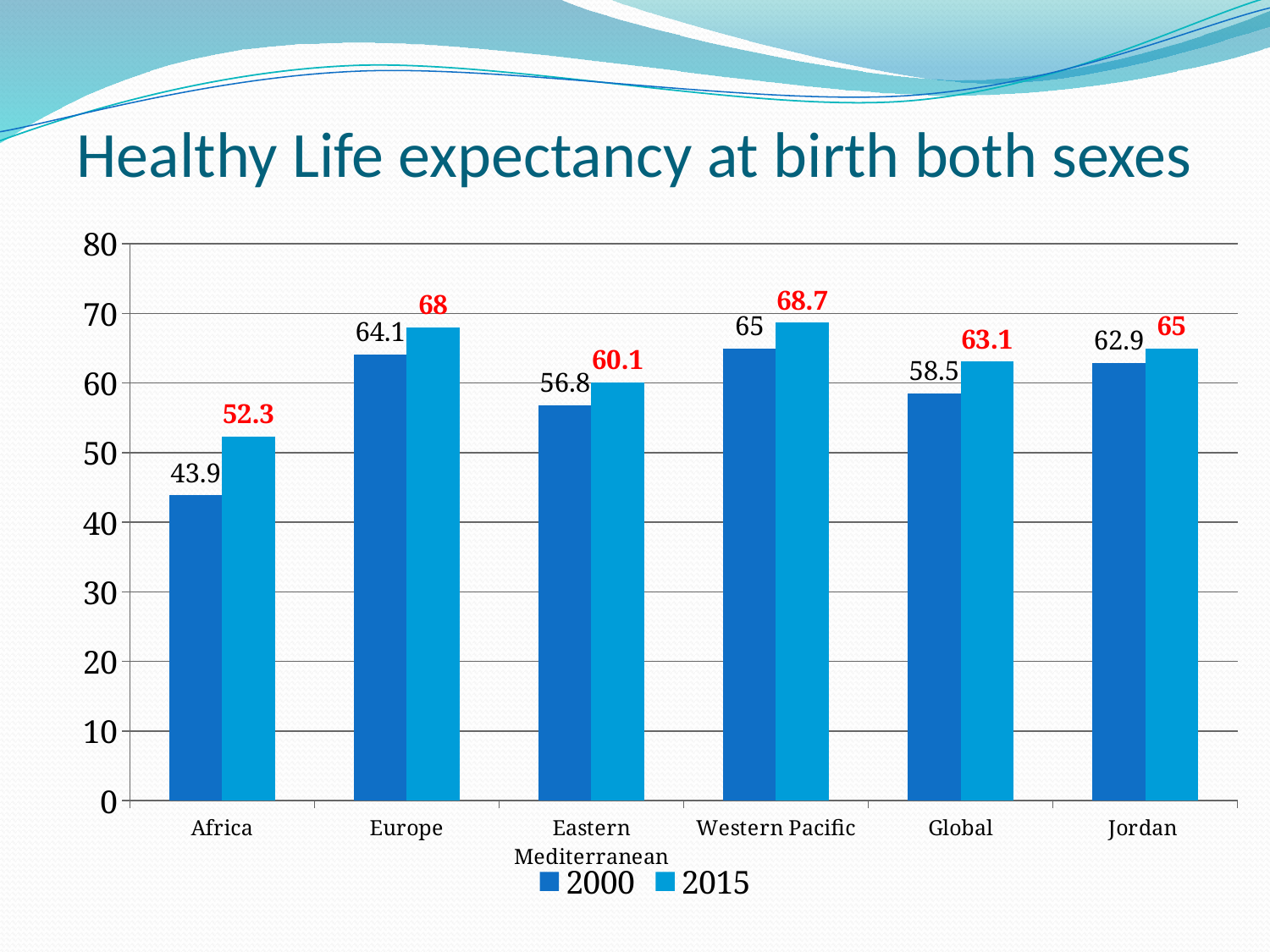
What is the difference between the 2015 and 2000 values for Africa? 8.4 What kind of chart is shown on the slide? Bar chart What is the title of the chart? Healthy Life expectancy at birth both sexes Which is larger, the 2000 value for Jordan or the 2000 value for Global? Jordan What is the 2015 value for Eastern Mediterranean? 60.1 Which category has the highest 2015 value? Western Pacific What is the difference between the 2015 values for Europe and Global? 4.9 How many series does the legend list? 2 What is the 2015 value for Jordan? 65 What is the 2000 value for Africa? 43.9 Which category has the lowest 2000 value? Africa How many categories are shown on the x axis? 6